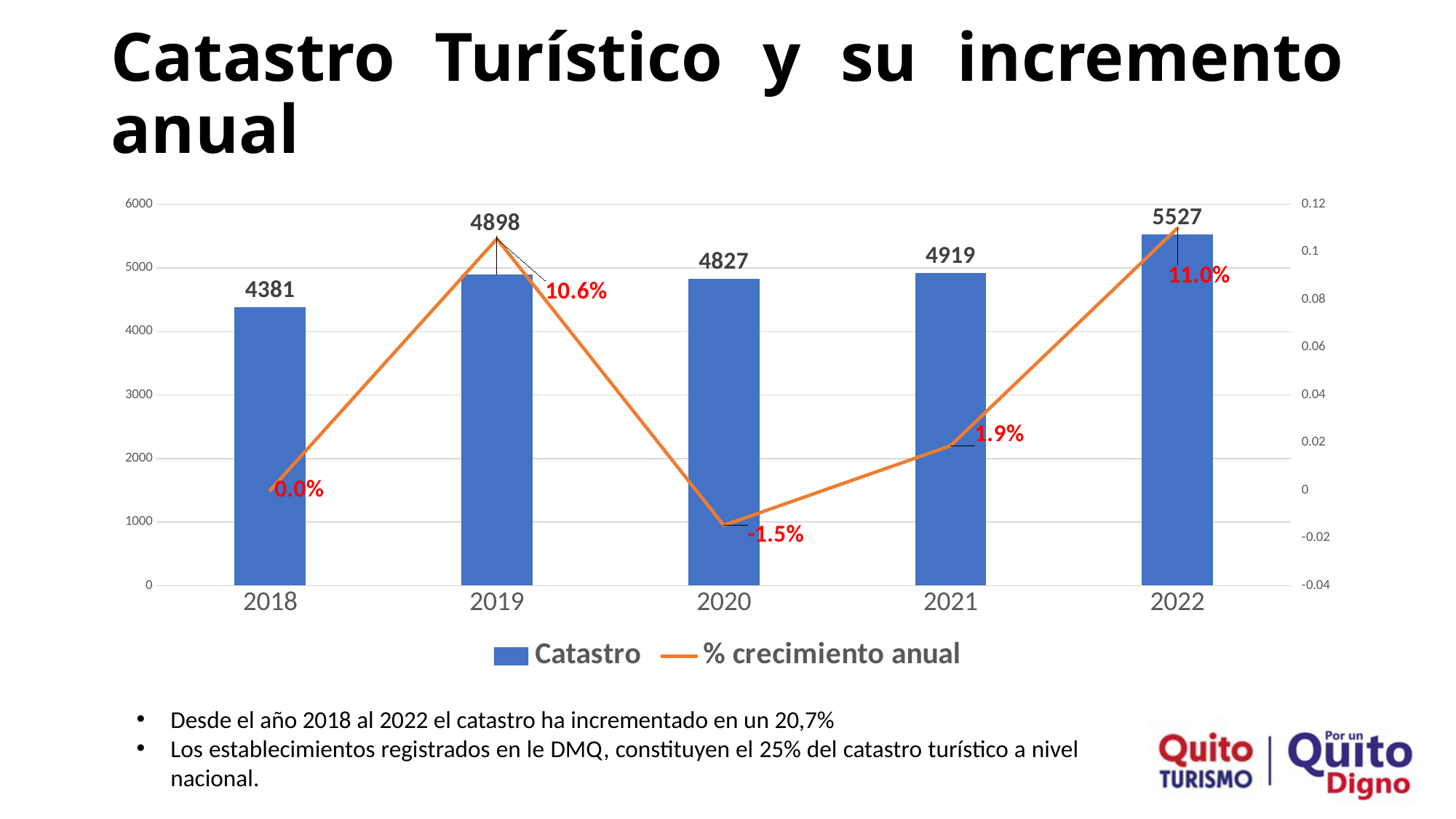
What is the difference between the Catastro values for 2022 and 2018? 1146 Which year has a larger Catastro value, 2019 or 2021? 2021 What is the % crecimiento anual value for 2019? 10.6% How many years are shown on the x axis? 5 What is the % crecimiento anual value for 2020? -1.5% Which year has the lowest % crecimiento anual value? 2020 Which year has the highest Catastro value? 2022 What colour is the % crecimiento anual line? Orange What is the Catastro value for 2022? 5527 How many series does the legend list? 2 Which year has the lowest Catastro value? 2018 What is the Catastro value for 2018? 4381